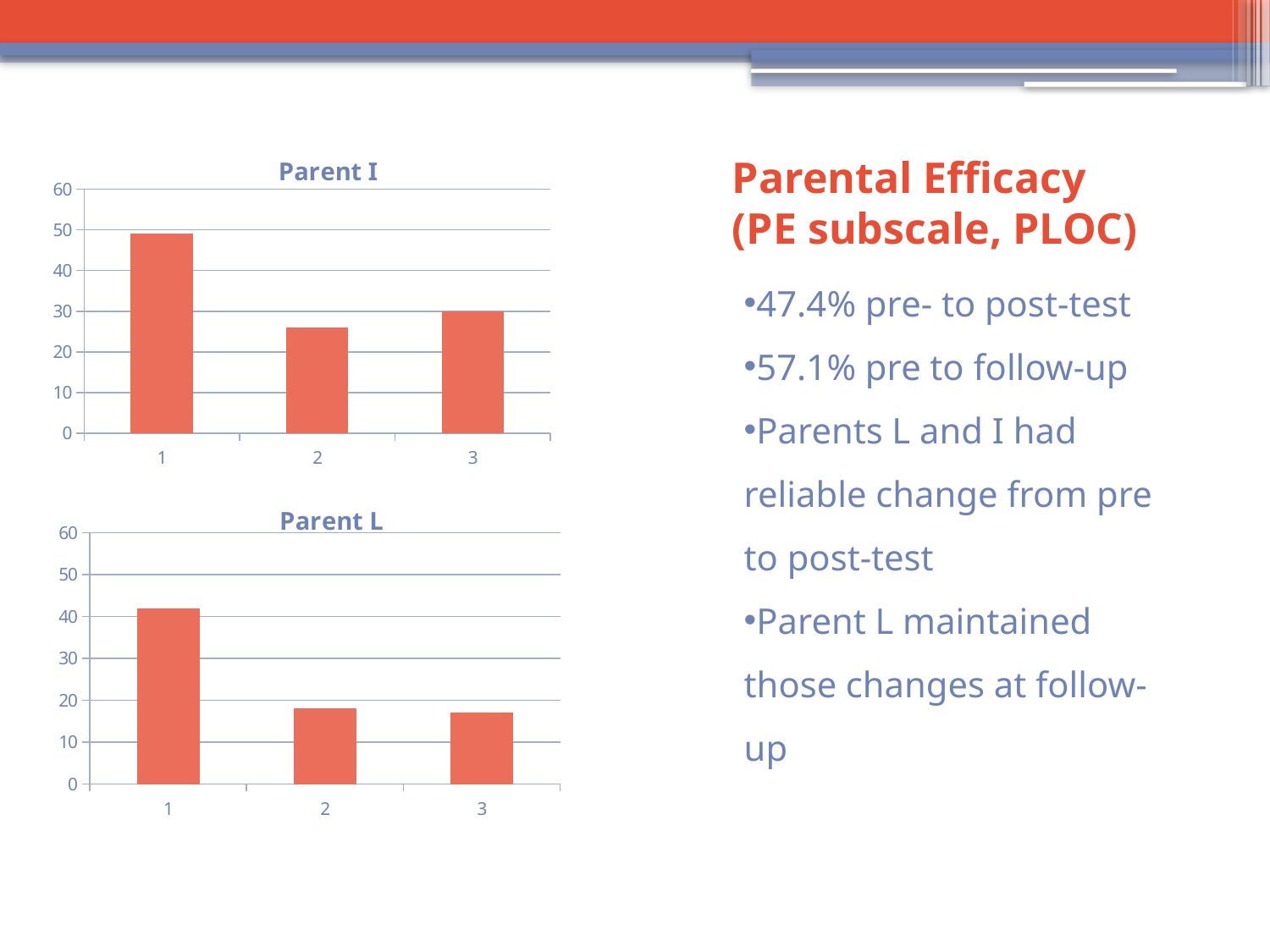
How many categories are shown on the Parent I chart? 3 On the Parent I chart, is the value for category 2 greater or less than 30? less How many bars are shown on the Parent L chart? 3 On the Parent I chart, which category has the lowest bar? 2 What is the title of the bottom chart on the slide? Parent L On the Parent I chart, which is larger, the value for category 1 or category 3? 1 On the Parent L chart, which category has the highest bar? 1 On the Parent L chart, is the value for category 3 greater or less than 20? less On the Parent I chart, which category has the highest bar? 1 What kind of chart is the Parent I chart? bar chart On the Parent I chart, is the value for category 1 greater or less than 40? greater